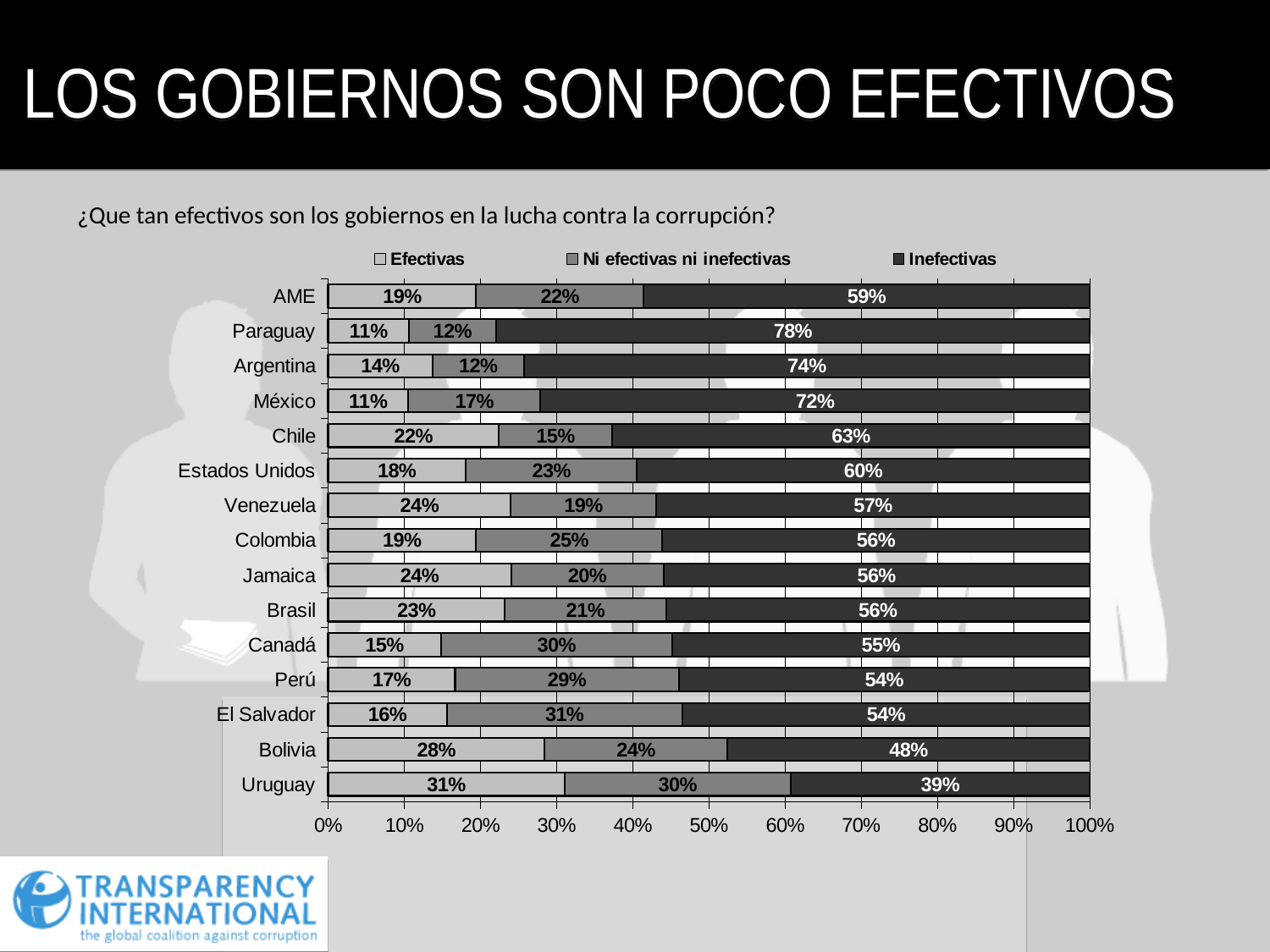
Which country has the highest Inefectivas percentage? Paraguay What percentage of respondents in Paraguay rated governments as Inefectivas? 78% How many countries or regions are listed on the chart? 15 What is the difference between the Inefectivas values for Paraguay and Uruguay? 39% What kind of chart is shown on the slide? Stacked bar chart What is the question shown above the chart? ¿Que tan efectivos son los gobiernos en la lucha contra la corrupción? Which is larger, the Efectivas value for Bolivia or the Efectivas value for Chile? Bolivia What is the Efectivas value for Uruguay? 31% What is the 'Ni efectivas ni inefectivas' value for Canadá? 30% What is the total of the three segments for the AME bar? 100% Which country has the lowest Inefectivas percentage? Uruguay How many series does the legend list? 3